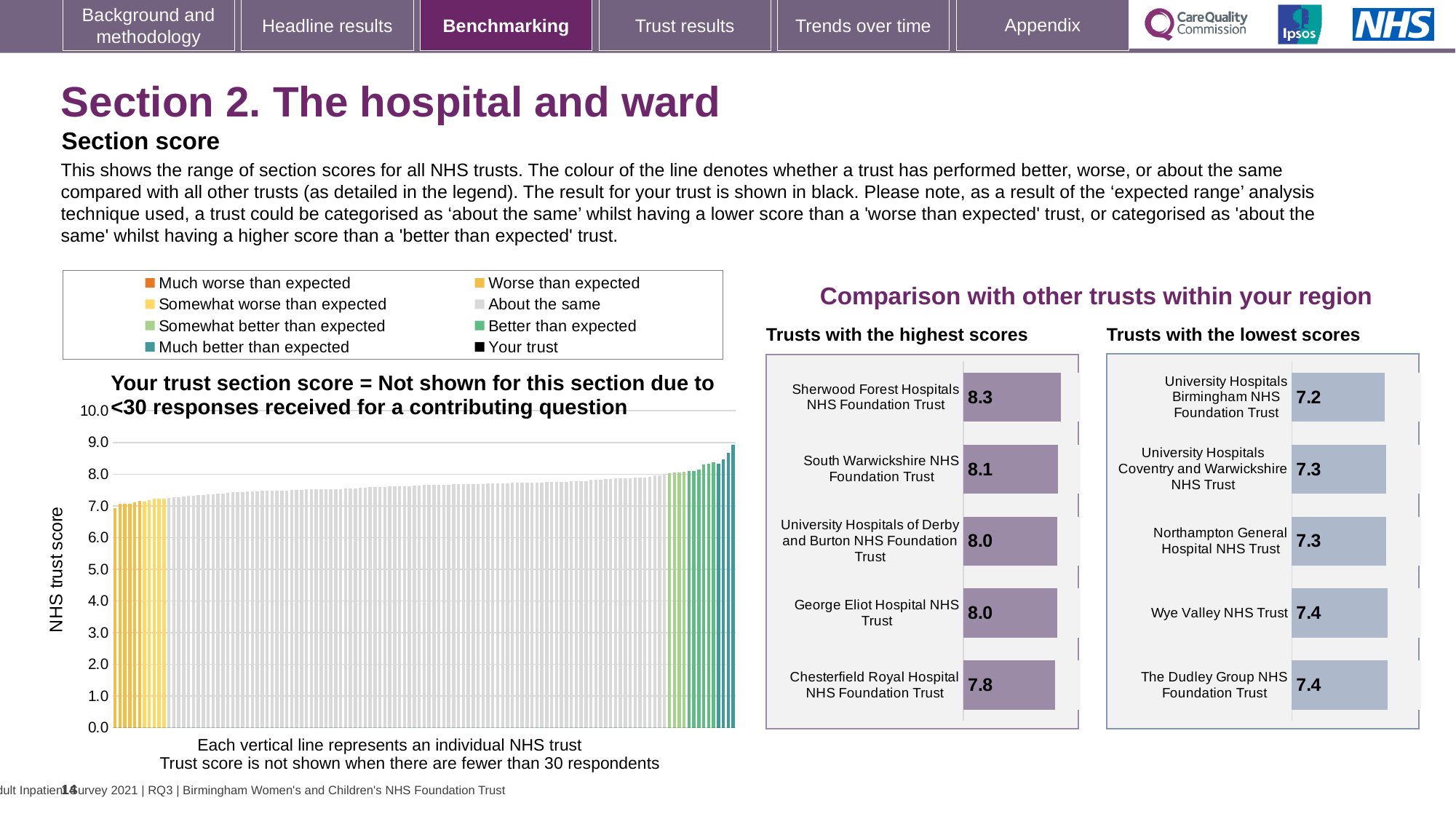
In the large chart on the left showing NHS trust scores, do the values rise or fall from left to right? rise In the 'Trusts with the lowest scores' chart, what is the score for Wye Valley NHS Trust? 7.4 How many entries does the legend above the large chart on the left list? 8 In the 'Trusts with the highest scores' chart, what is the difference between the scores of Sherwood Forest Hospitals NHS Foundation Trust and Chesterfield Royal Hospital NHS Foundation Trust? 0.5 In the 'Trusts with the highest scores' chart, what is the score for Sherwood Forest Hospitals NHS Foundation Trust? 8.3 In the 'Trusts with the lowest scores' chart, what is the score for University Hospitals Birmingham NHS Foundation Trust? 7.2 In the 'Trusts with the highest scores' chart, which trust has the highest score? Sherwood Forest Hospitals NHS Foundation Trust How many trusts are listed in the 'Trusts with the lowest scores' chart? 5 In the 'Trusts with the highest scores' chart, what is the score for Chesterfield Royal Hospital NHS Foundation Trust? 7.8 What kind of chart is the large chart on the left showing the range of section scores for all NHS trusts? bar chart In the 'Trusts with the highest scores' chart, which has the larger score: South Warwickshire NHS Foundation Trust or Chesterfield Royal Hospital NHS Foundation Trust? South Warwickshire NHS Foundation Trust In the 'Trusts with the lowest scores' chart, which trust has the lowest score? University Hospitals Birmingham NHS Foundation Trust